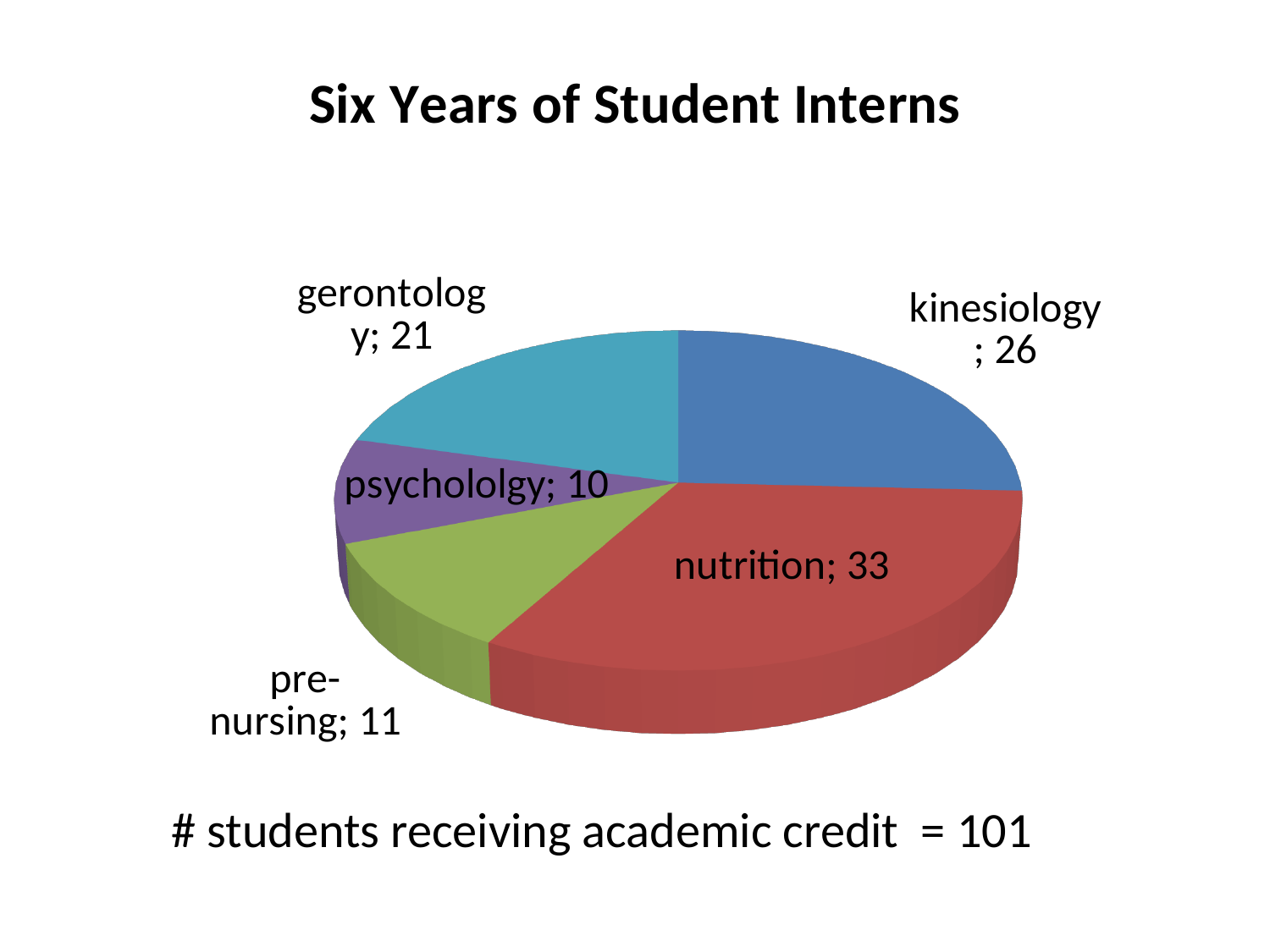
Which field has the smallest slice of the pie? psychololgy What is the title of the chart? Six Years of Student Interns How many student interns were in nutrition? 33 How many fields (slices) are shown in the pie chart? 5 What kind of chart is shown on the slide? pie chart Which field has the largest slice of the pie? nutrition What is the total number of students receiving academic credit shown on the slide? 101 How many student interns were in pre-nursing? 11 How many student interns were in kinesiology? 26 How many student interns were in gerontology? 21 Which had more interns, gerontology or pre-nursing? gerontology What is the difference between the number of nutrition interns and kinesiology interns? 7